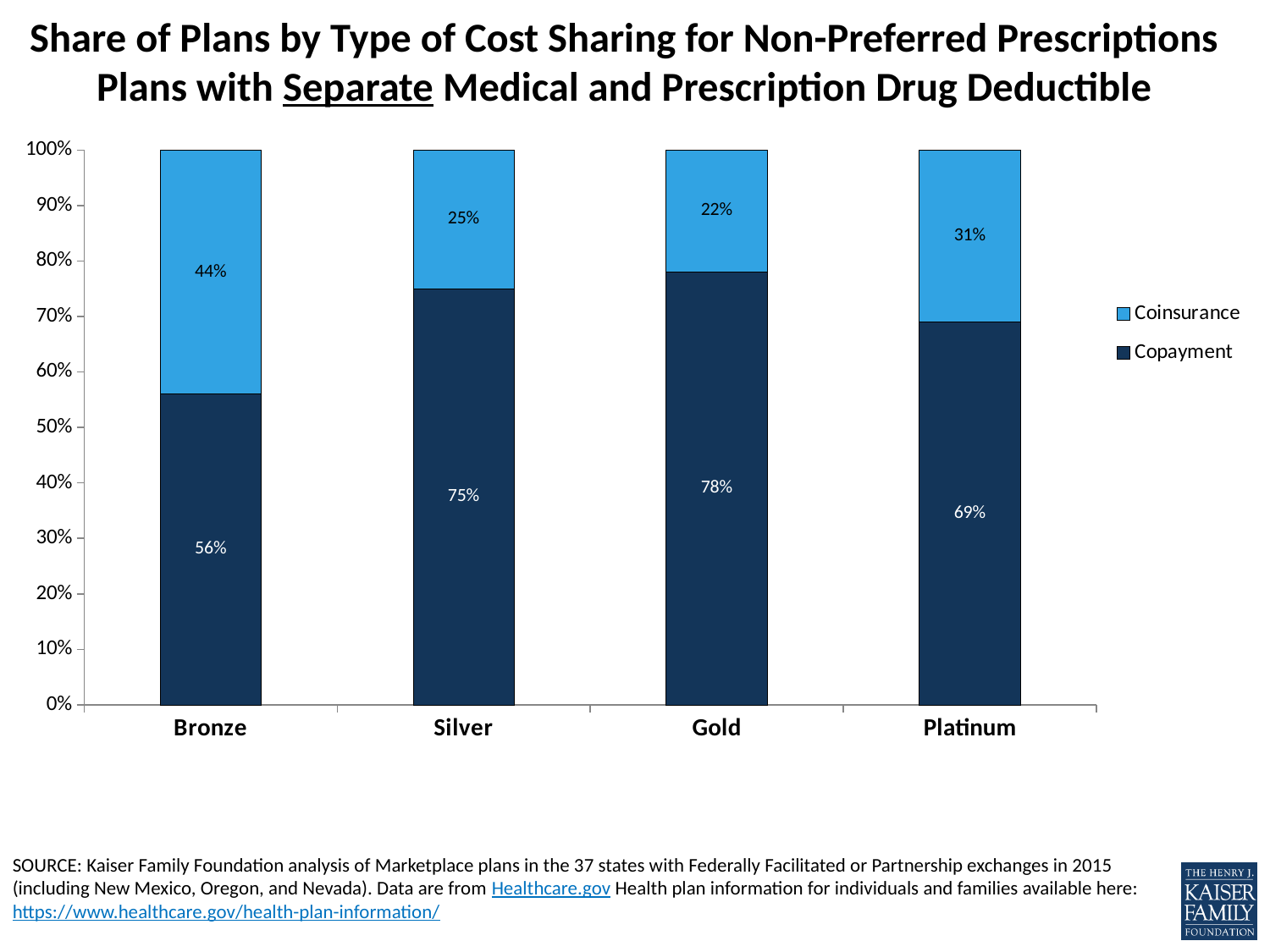
Which is larger: the Coinsurance share for Platinum or the Coinsurance share for Silver? Platinum What is the difference between the Copayment share for Silver and the Copayment share for Bronze? 19% What is the Copayment share for Platinum plans? 69% Which plan type has the highest Coinsurance share? Bronze Which plan type has the lowest Coinsurance share? Gold How many series does the legend list? 2 What is the Coinsurance share for Gold plans? 22% Which plan type has the highest Copayment share? Gold How many plan types are shown on the x axis? 4 What is the Coinsurance share for Silver plans? 25% What is the Copayment share for Bronze plans? 56% What kind of chart is shown on the slide? Stacked bar chart